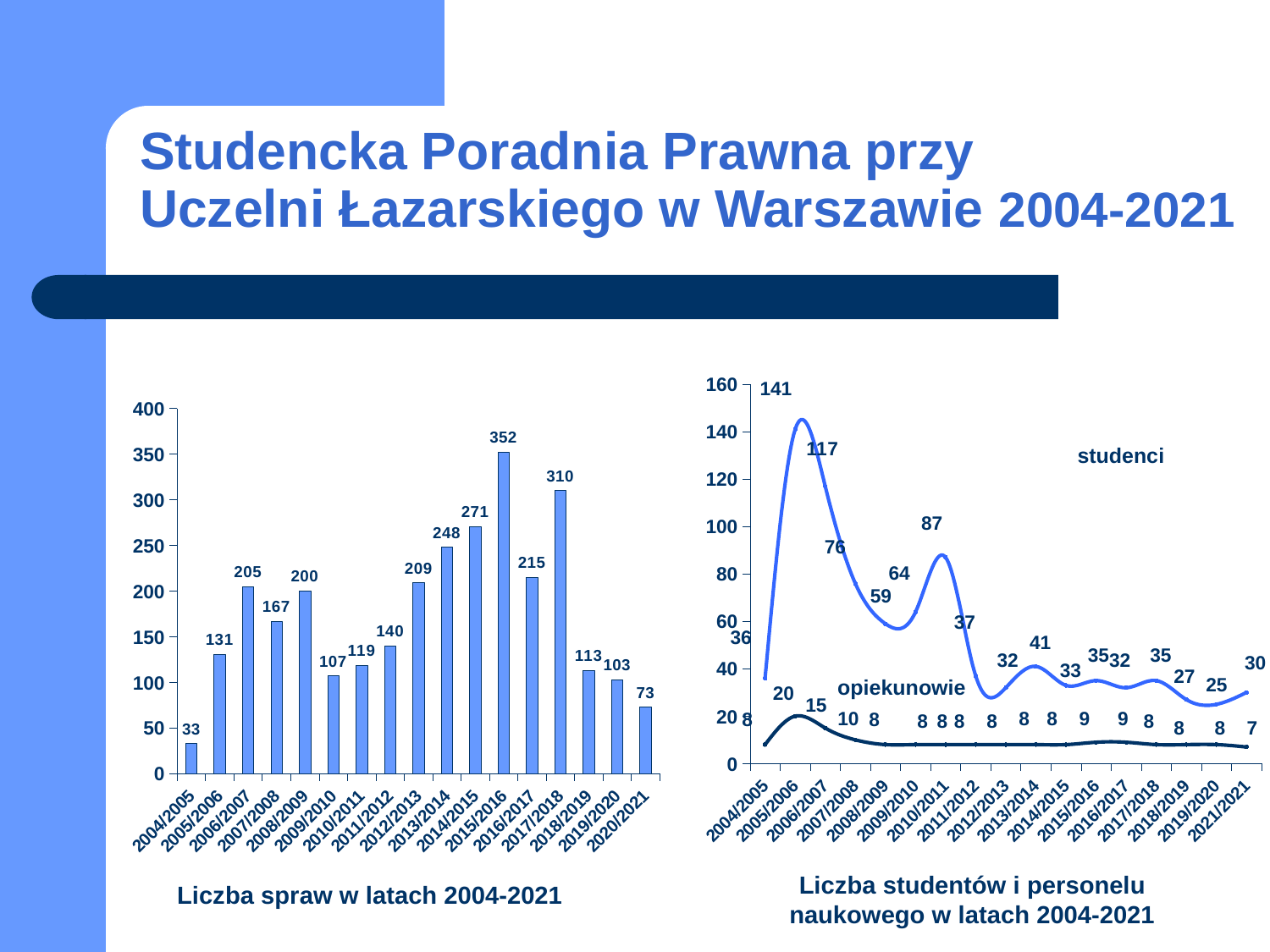
In the chart titled 'Liczba spraw w latach 2004-2021', which year has the lowest value? 2004/2005 In the chart titled 'Liczba spraw w latach 2004-2021', how many years are shown on the x axis? 17 In the chart titled 'Liczba spraw w latach 2004-2021', which is larger, the value for 2006/2007 or the value for 2008/2009? 2006/2007 In the chart titled 'Liczba studentów i personelu naukowego w latach 2004-2021', what is the highest value of the 'studenci' series? 141 In the chart titled 'Liczba spraw w latach 2004-2021', which year has the highest value? 2015/2016 What kind of chart is the chart titled 'Liczba spraw w latach 2004-2021'? bar chart In the chart titled 'Liczba studentów i personelu naukowego w latach 2004-2021', what is the highest value of the 'opiekunowie' series? 20 In the chart titled 'Liczba spraw w latach 2004-2021', what is the difference between the values for 2017/2018 and 2016/2017? 95 In the chart titled 'Liczba studentów i personelu naukowego w latach 2004-2021', what are the two series labelled? studenci and opiekunowie What kind of chart is the chart titled 'Liczba studentów i personelu naukowego w latach 2004-2021'? line chart In the chart titled 'Liczba spraw w latach 2004-2021', what is the value for 2015/2016? 352 In the chart titled 'Liczba spraw w latach 2004-2021', what is the value for 2004/2005? 33